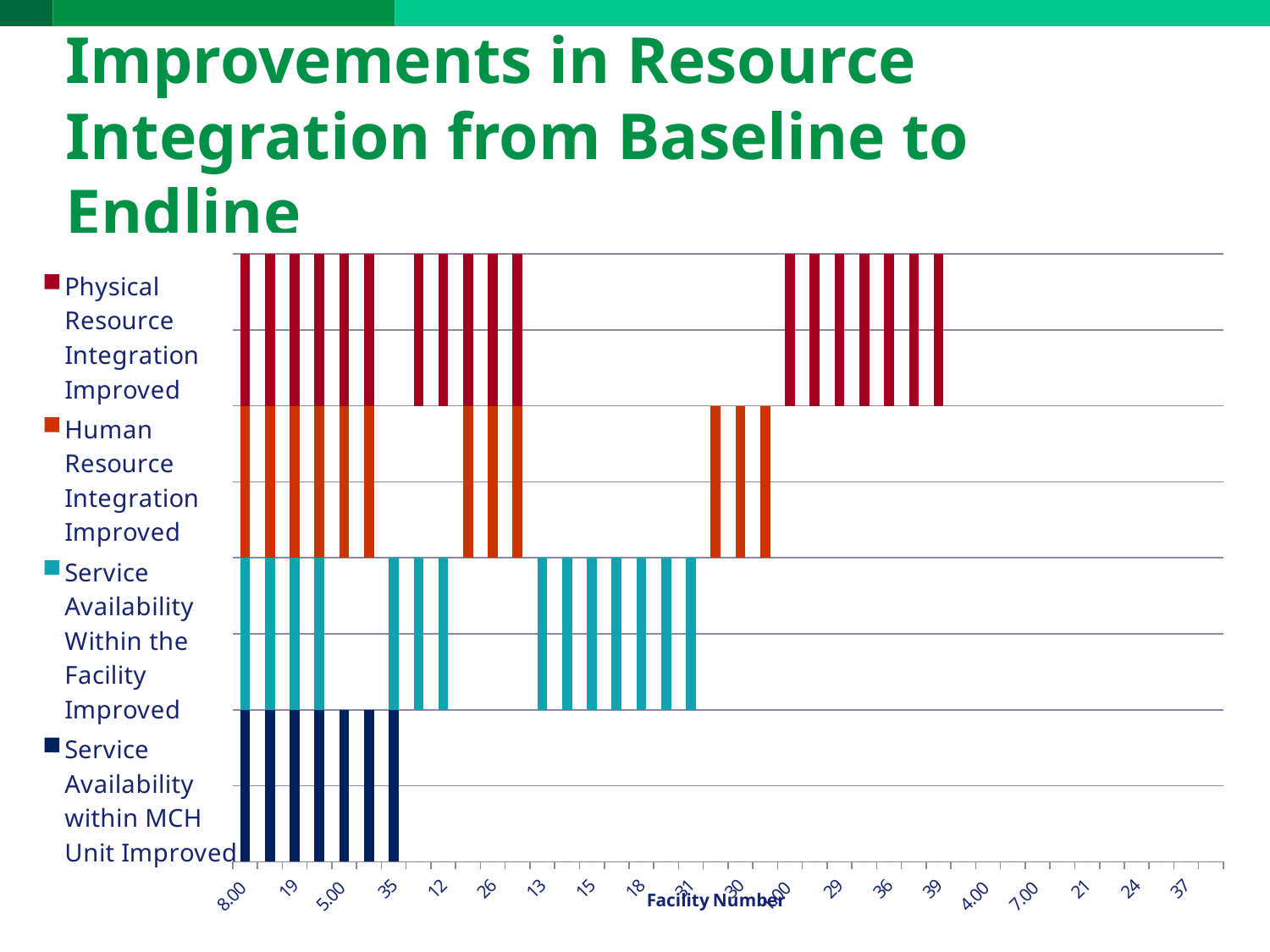
Which series has bars for the fewest facilities? Service Availability within MCH Unit Improved What kind of chart is shown on the slide? bar chart Which series is shown in dark navy blue? Service Availability within MCH Unit Improved Which series has bars for the most facilities? Physical Resource Integration Improved What is the title of the x axis? Facility Number How many series does the legend list? 4